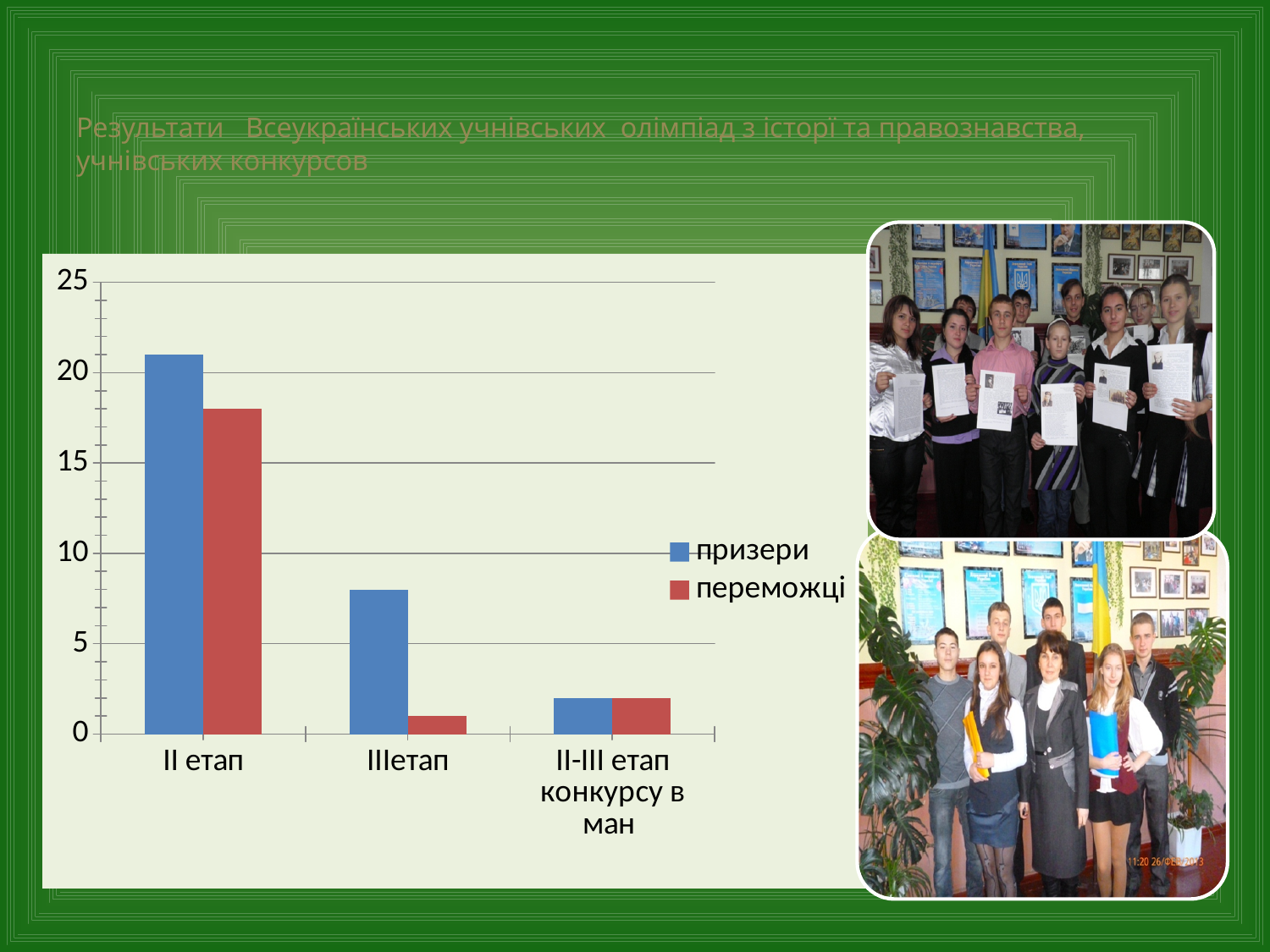
How many series does the chart legend list? 2 Is the value for призери in ІІ етап greater or less than 15? greater Is the value for переможці in ІІ етап greater or less than 15? greater In ІІ етап, which series has the larger value, призери or переможці? призери Do the values for the призери series rise or fall from left to right along the x axis? fall How many categories are shown on the x axis of the chart? 3 Which category has the highest value for the призери series? ІІ етап What colour are the bars for the переможці series? red What kind of chart is shown on the slide? bar chart Is the value for призери in ІІІетап greater or less than 10? less Which category has the lowest value for the переможці series? ІІІетап